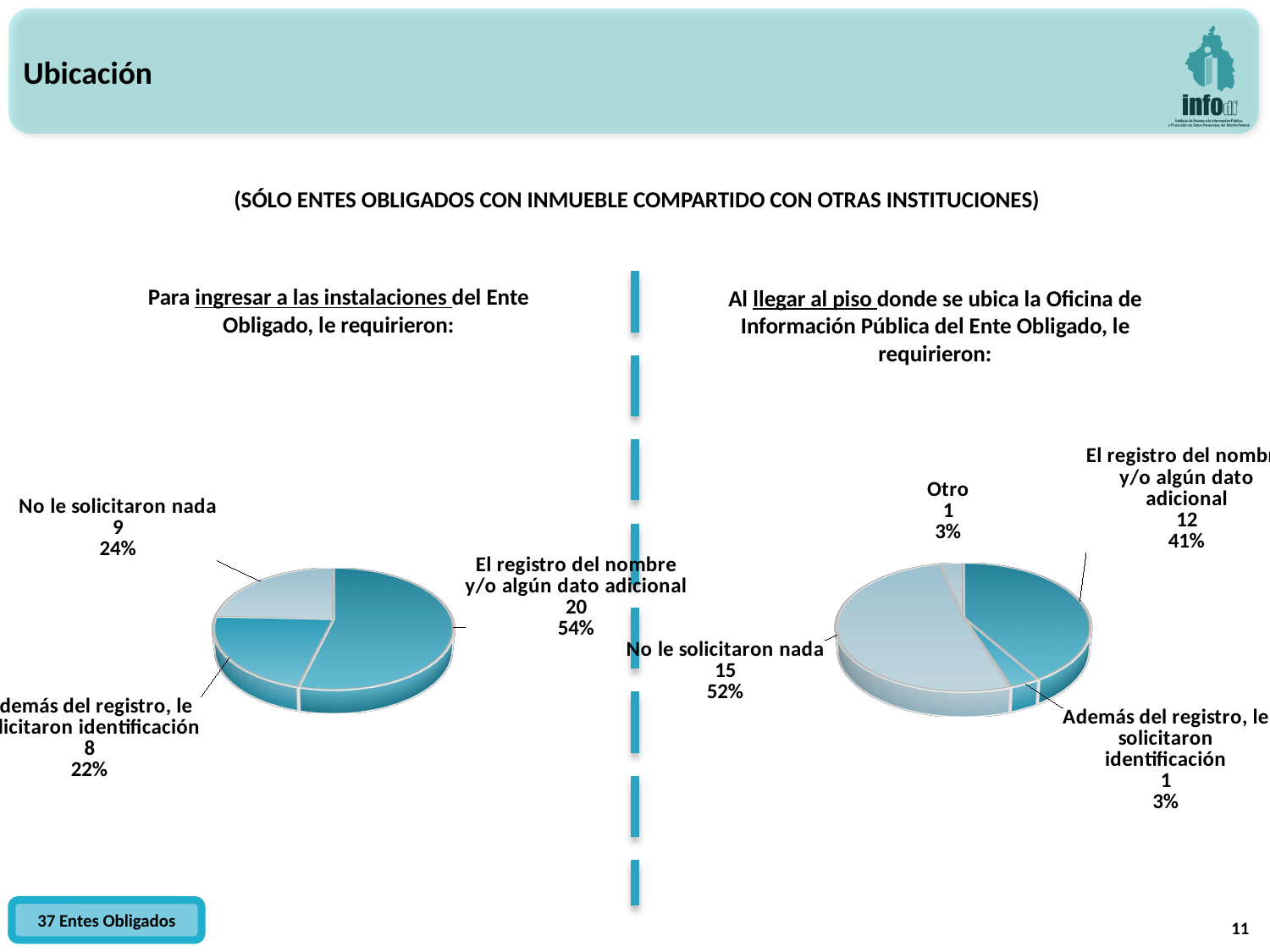
In the left pie chart (Para ingresar a las instalaciones), what percentage share does 'No le solicitaron nada' have? 24% What type of chart is used on this slide? Pie chart In the right pie chart (Al llegar al piso), how many entes obligados answered 'No le solicitaron nada'? 15 Which is larger: the count for 'No le solicitaron nada' in the left pie chart or in the right pie chart? Right pie chart (15) In the left pie chart (Para ingresar a las instalaciones), what is the difference between the count for 'El registro del nombre y/o algún dato adicional' and the count for 'No le solicitaron nada'? 11 In the right pie chart (Al llegar al piso), how many categories are shown? 4 In the right pie chart (Al llegar al piso), what percentage share does 'El registro del nombre y/o algún dato adicional' have? 41% In the left pie chart (Para ingresar a las instalaciones), how many categories are shown? 3 In the left pie chart (Para ingresar a las instalaciones), which category has the largest slice? El registro del nombre y/o algún dato adicional In the right pie chart (Al llegar al piso), which category has the largest slice? No le solicitaron nada In the left pie chart (Para ingresar a las instalaciones), how many entes obligados answered 'El registro del nombre y/o algún dato adicional'? 20 In the right pie chart (Al llegar al piso), what is the count for 'Otro'? 1